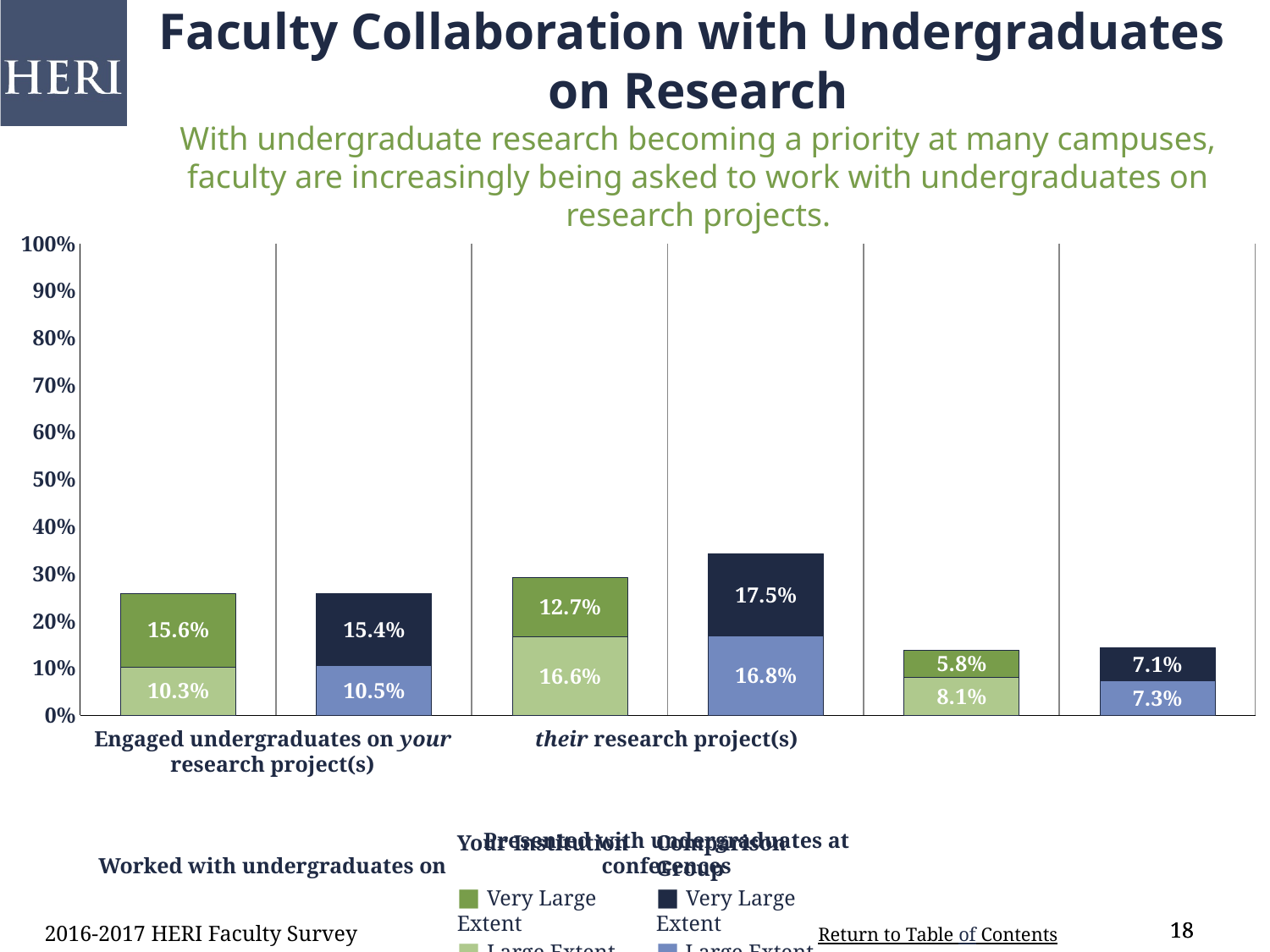
What is the Very Large Extent value for the Comparison Group on 'Worked with undergraduates on their research project(s)'? 17.5% How many activity categories are shown along the x axis of the chart? 3 What is the total of the Your Institution stacked bar for 'Worked with undergraduates on their research project(s)'? 29.3% What is the difference between the Comparison Group and Your Institution Very Large Extent values for 'Worked with undergraduates on their research project(s)'? 4.8 percentage points What is the Large Extent value for Your Institution on 'Presented with undergraduates at conferences'? 8.1% What is the total of the Comparison Group stacked bar for 'Worked with undergraduates on their research project(s)'? 34.3% What is the Large Extent value for the Comparison Group on 'Engaged undergraduates on your research project(s)'? 10.5% For 'Engaged undergraduates on your research project(s)', which has the larger Very Large Extent value, Your Institution or the Comparison Group? Your Institution What kind of chart is shown on the slide? Stacked bar chart What is the Very Large Extent value for Your Institution on 'Engaged undergraduates on your research project(s)'? 15.6% Is the total of the Comparison Group stacked bar for 'Worked with undergraduates on their research project(s)' greater or less than 30%? greater Which stacked bar is the tallest on the chart? Comparison Group, Worked with undergraduates on their research project(s)